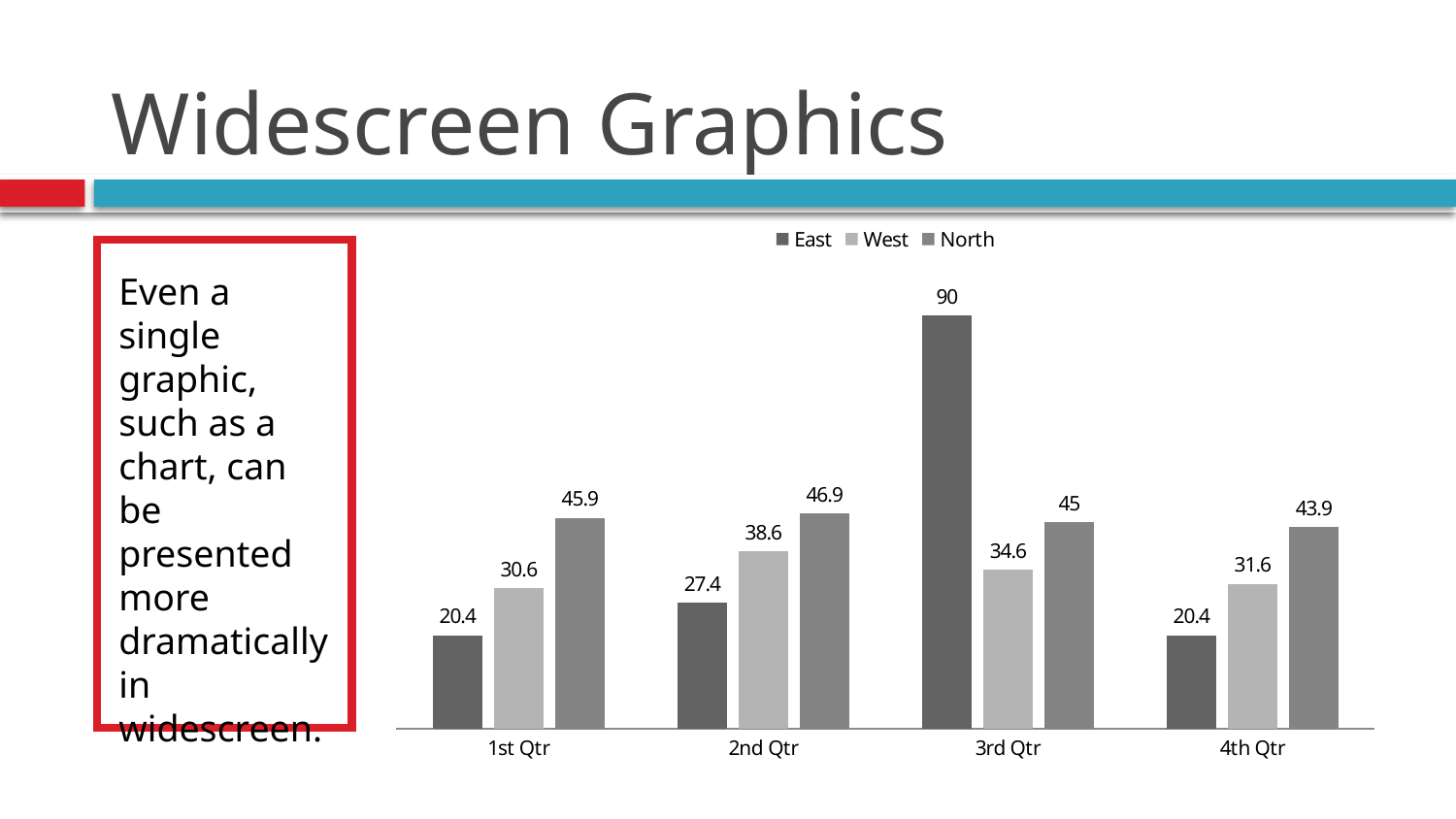
What kind of chart is shown on the slide? Bar chart What is the value for East in 3rd Qtr? 90 Which is larger in 2nd Qtr, the West value or the North value? North Does the West value rise or fall from 3rd Qtr to 4th Qtr? Fall Which quarter has the lowest value for West? 1st Qtr What are the three series named in the legend? East, West, North Which quarter has the highest value for East? 3rd Qtr What is the difference between the North and East values in 1st Qtr? 25.5 What is the value for West in 2nd Qtr? 38.6 What is the value for North in 4th Qtr? 43.9 How many quarters are shown on the x axis? 4 How many series does the legend list? 3